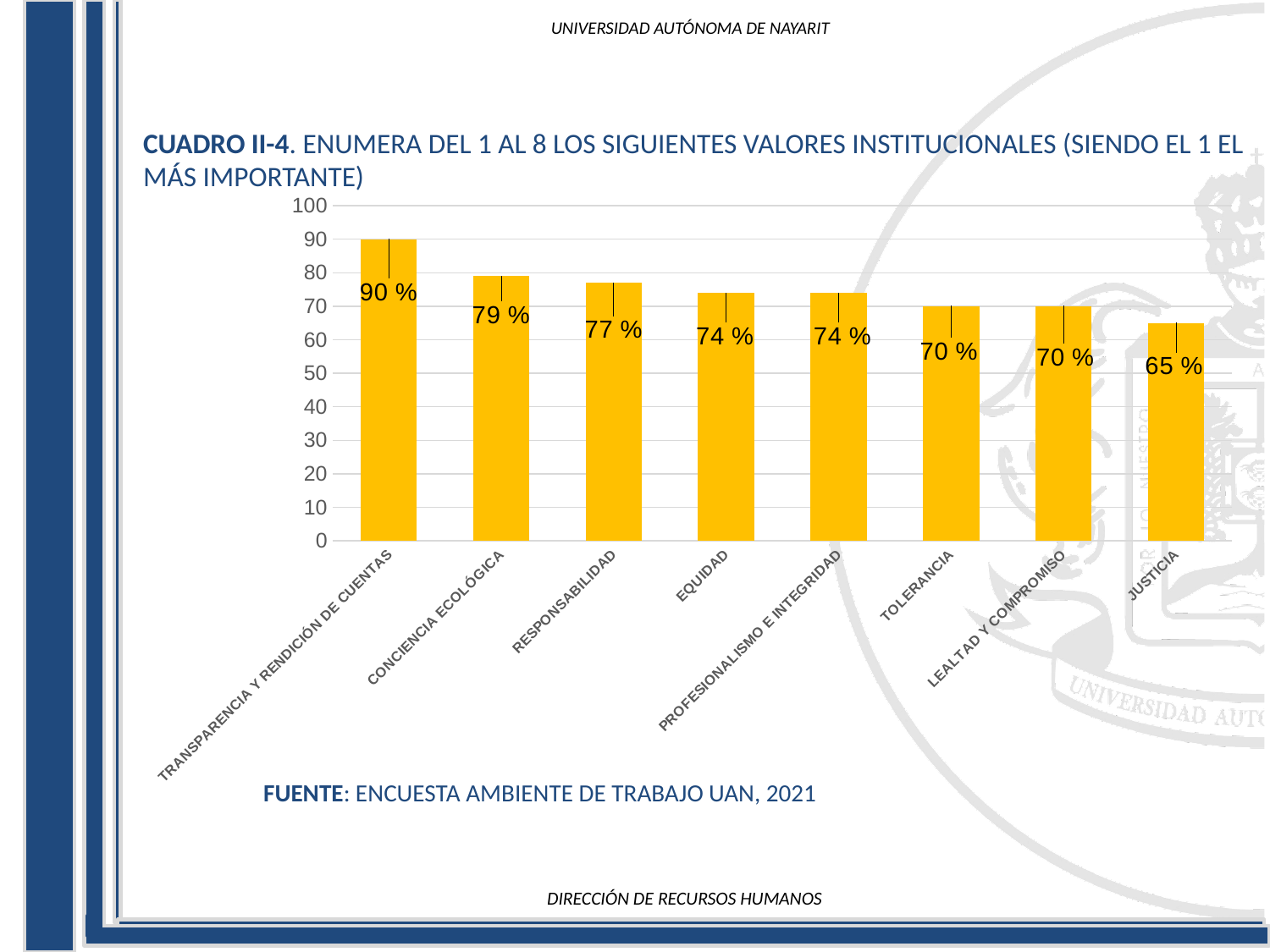
Do the values rise or fall from left to right along the x axis? Fall What is the value for CONCIENCIA ECOLÓGICA? 79 % What is the value for RESPONSABILIDAD? 77 % Which category has the lowest value? JUSTICIA What is the value for JUSTICIA? 65 % What is the difference between the values for TRANSPARENCIA Y RENDICIÓN DE CUENTAS and JUSTICIA? 25 % Which category has the highest value? TRANSPARENCIA Y RENDICIÓN DE CUENTAS What is the value for TRANSPARENCIA Y RENDICIÓN DE CUENTAS? 90 % How many categories are shown in the chart? 8 What source is cited below the chart? ENCUESTA AMBIENTE DE TRABAJO UAN, 2021 Which is larger, the value for CONCIENCIA ECOLÓGICA or the value for TOLERANCIA? CONCIENCIA ECOLÓGICA What kind of chart is shown on the slide? Bar chart